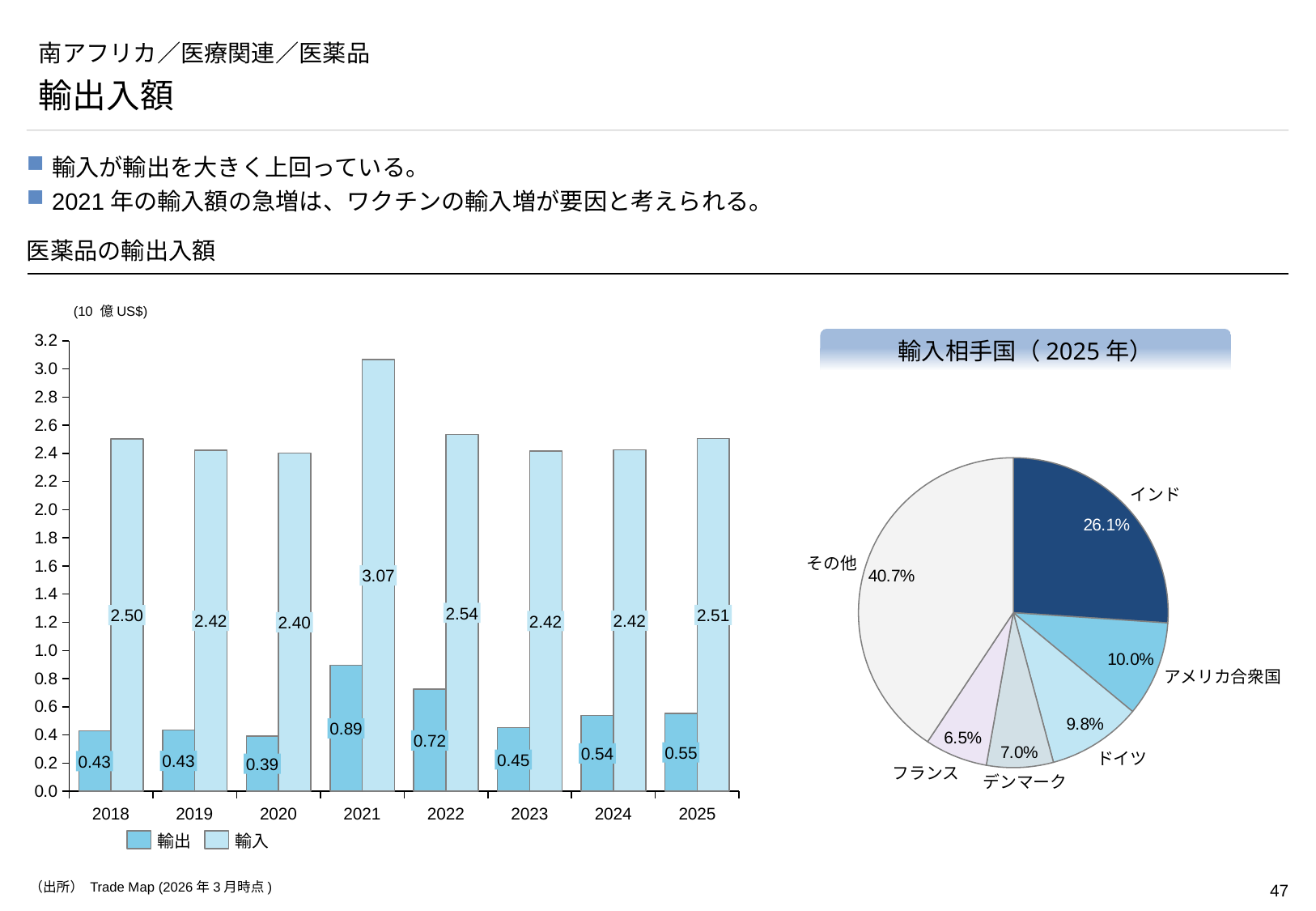
「医薬品の輸出入額」のグラフで、2025年の輸出の値はいくらですか？ 0.55 「医薬品の輸出入額」のグラフは、どの種類のグラフですか？ 棒グラフ 「輸入相手国（2025年）」の円グラフで、国名が示された中で最も割合が小さい国はどれですか？ フランス 「医薬品の輸出入額」のグラフで、2021年の輸入と輸出の差はいくらですか？ 2.17 「輸入相手国（2025年）」の円グラフは、どの種類のグラフですか？ 円グラフ 「医薬品の輸出入額」のグラフで、2021年の輸入の値はいくらですか？ 3.07 「医薬品の輸出入額」のグラフで、2022年の輸出と2024年の輸出ではどちらが大きいですか？ 2022年 「医薬品の輸出入額」のグラフで、輸出が最も少ない年はどれですか？ 2020 「医薬品の輸出入額」のグラフには、いくつの年が表示されていますか？ 8 「輸入相手国（2025年）」の円グラフで、インドの割合はいくらですか？ 26.1% 「医薬品の輸出入額」のグラフの凡例には、いくつの系列がありますか？ 2 「医薬品の輸出入額」のグラフで、輸入が最も多い年はどれですか？ 2021